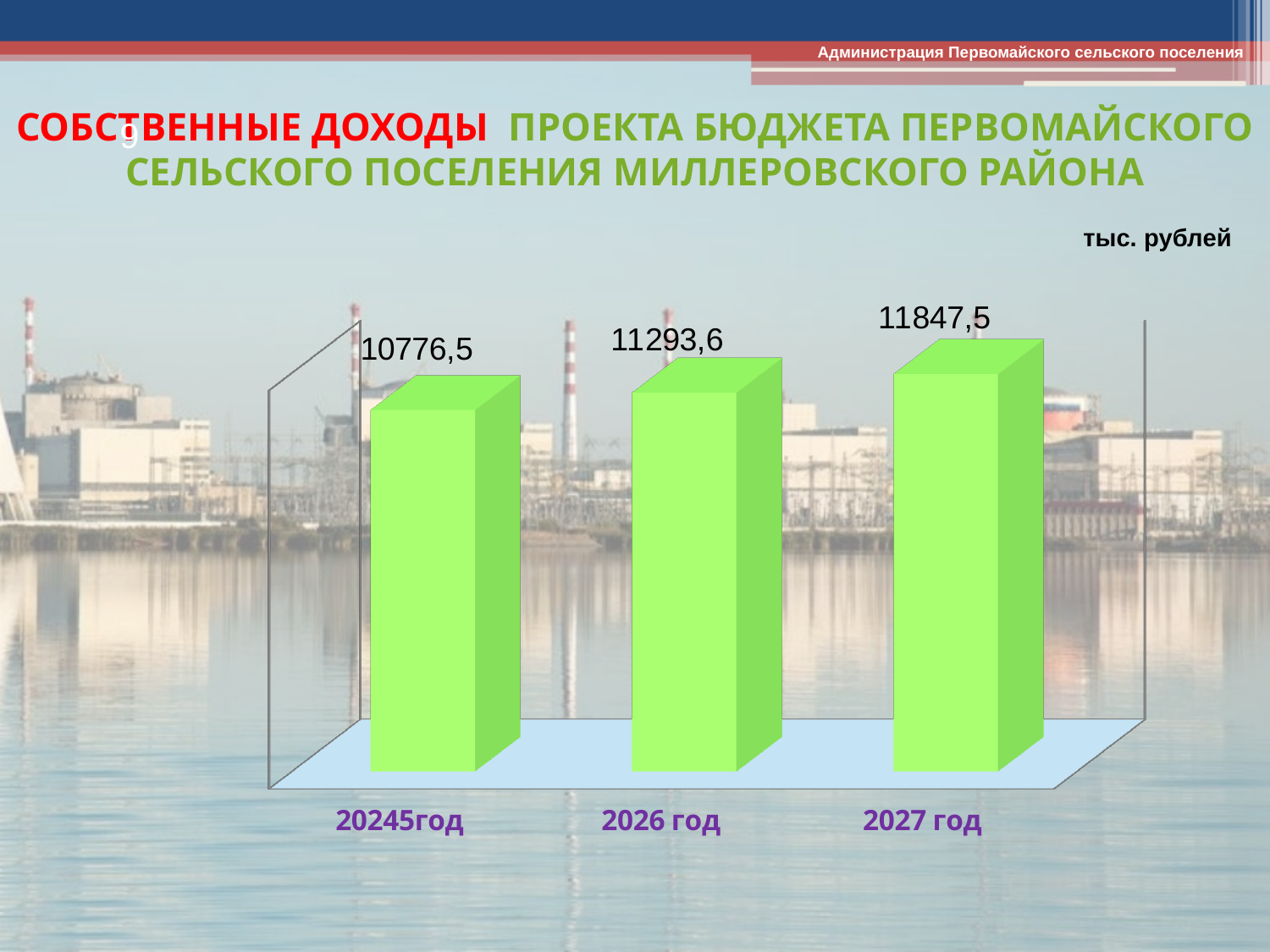
Which year has the highest value? 2027 год How many bars are shown in the chart? 3 Which bar has the lowest value? 20245год Do the values rise or fall from left to right across the years? rise What is the difference between the values for 2027 год and the first bar (20245год)? 1071,0 What kind of chart is shown on the slide? bar chart What value is shown for 2027 год? 11847,5 Which is larger, the value for 2026 год or the value for 2027 год? 2027 год What is the difference between the values for 2026 год and the first bar (20245год)? 517,1 What is the difference between the values for 2027 год and 2026 год? 553,9 What value is shown for 2026 год? 11293,6 What value is shown for the first bar, labelled 20245год? 10776,5